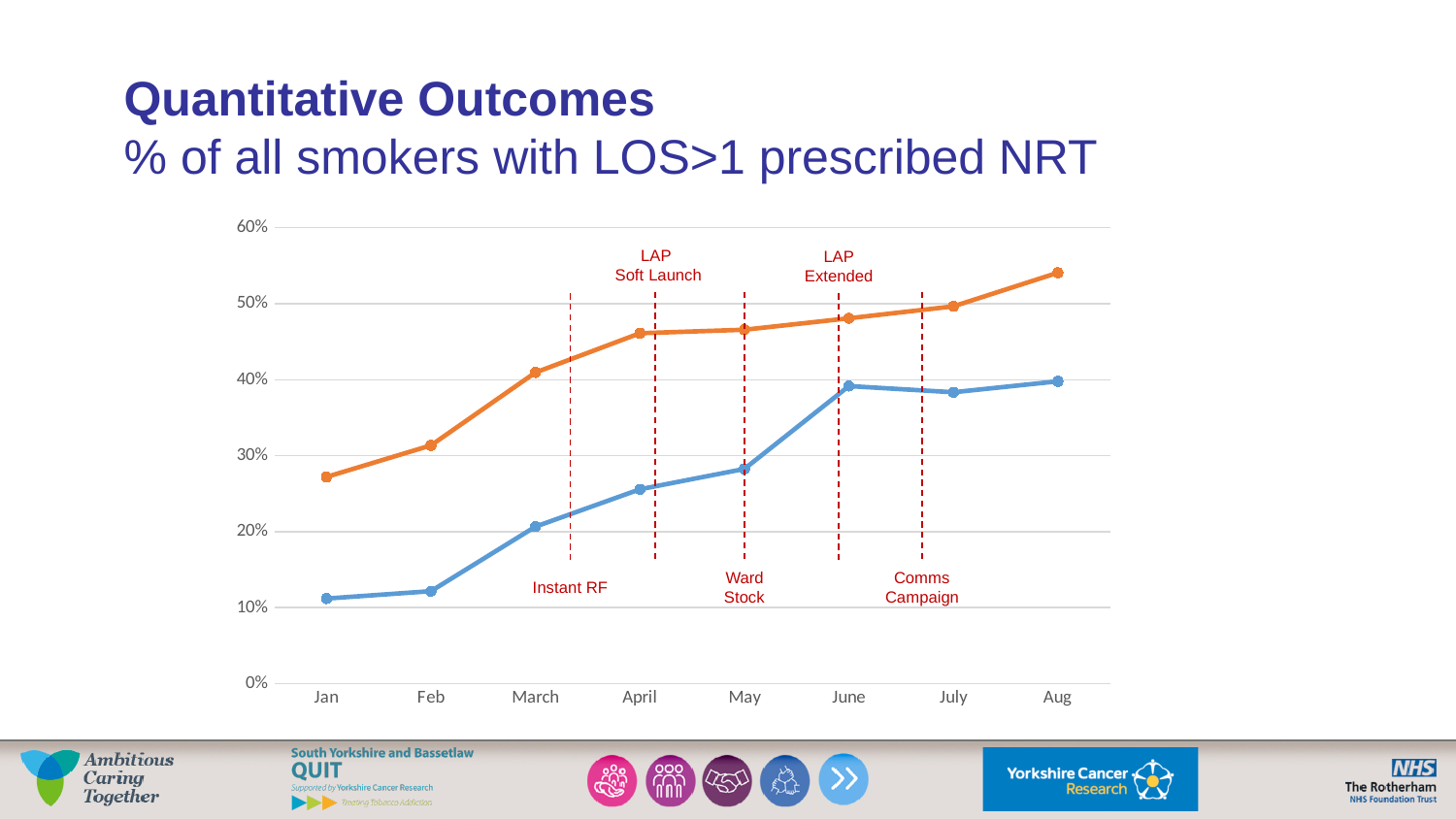
Does the orange line generally rise or fall from Jan to Aug? Rise Is the value of the blue line in Jan greater or less than 20%? less What is the highest value shown on the y axis of the chart? 60% Is the value of the blue line in June greater or less than 30%? greater What event is labelled on the chart between April and May? LAP Soft Launch In which month does the orange line reach its highest value? Aug Is the value of the orange line in Aug greater or less than 50%? greater In which month is the orange line at its lowest value? Jan In March, which line is higher, the blue line or the orange line? Orange line What kind of chart is shown on the slide? Line chart How many months are shown along the x axis of the chart? 8